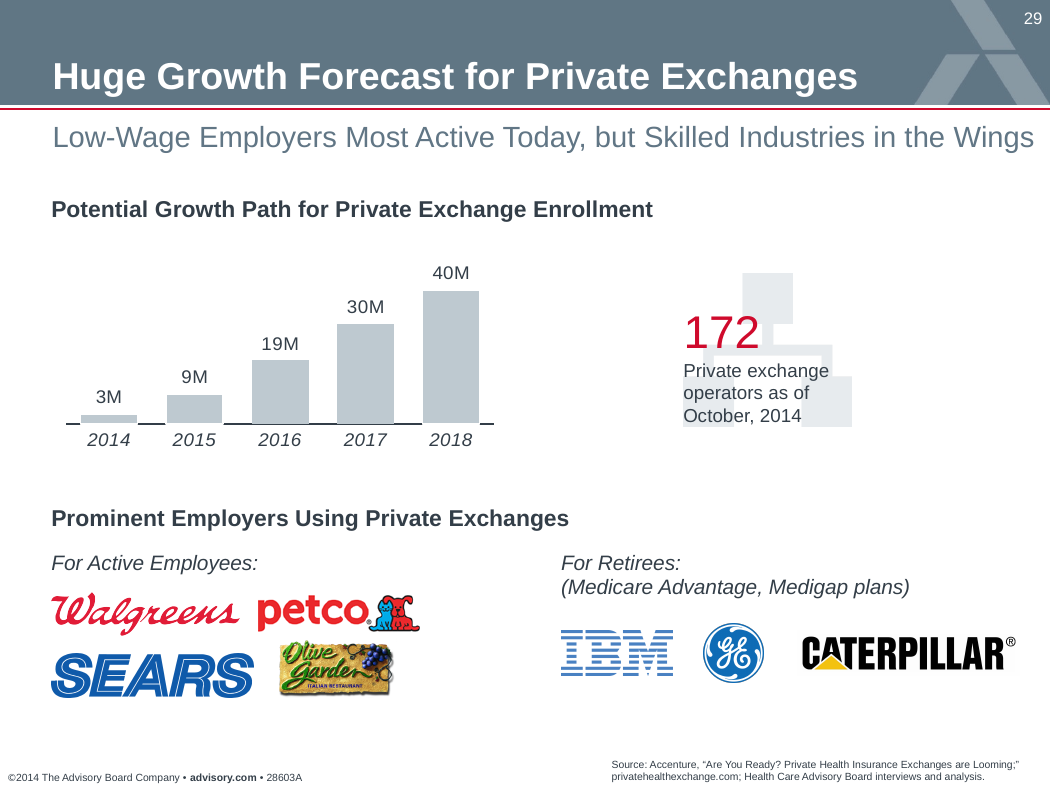
Do the values in the enrollment chart rise or fall from 2014 to 2018? Rise Which is larger in the enrollment chart, the value for 2015 or the value for 2017? 2017 What is the value for 2018 in the enrollment chart? 40M What is the difference between the 2018 and 2017 values in the enrollment chart? 10M What kind of chart is used to show the Potential Growth Path for Private Exchange Enrollment? Bar chart Which year has the highest value in the enrollment chart? 2018 What is the value for 2014 in the enrollment chart? 3M How many years are shown on the x axis of the enrollment chart? 5 What is the value for 2016 in the Potential Growth Path for Private Exchange Enrollment chart? 19M What is the title of the chart on the slide? Potential Growth Path for Private Exchange Enrollment Which year has the lowest value in the enrollment chart? 2014 What is the difference between the 2016 and 2015 values in the enrollment chart? 10M